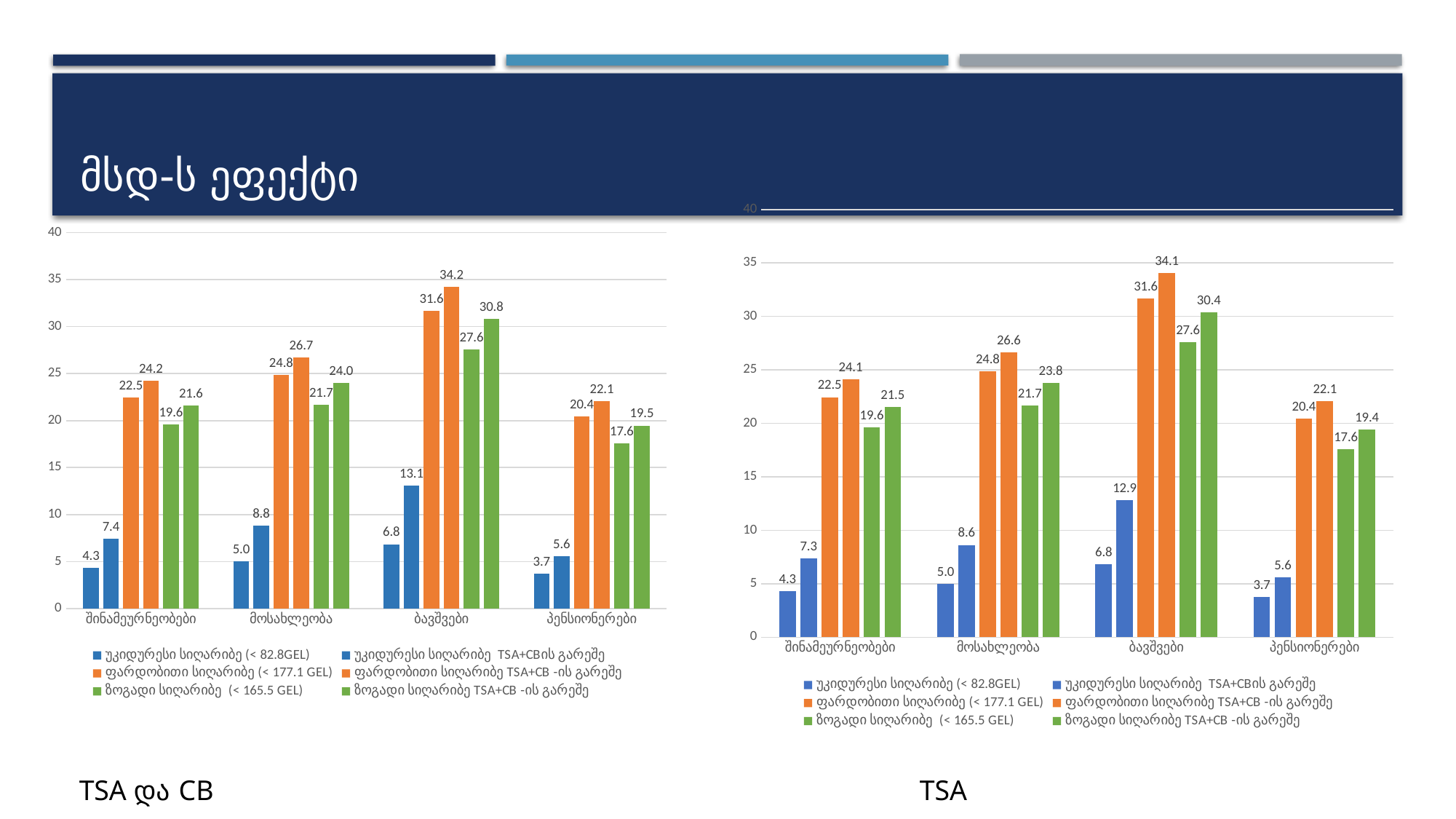
In the left chart (TSA და CB), what is the value of ფარდობითი სიღარიბე TSA+CB -ის გარეშე for მოსახლეობა? 26.7 In the right chart (TSA), what is the difference between ფარდობითი სიღარიბე TSA+CB -ის გარეშე (34.1) and ფარდობითი სიღარიბე (< 177.1 GEL) (31.6) for ბავშვები? 2.5 Which is larger: the ზოგადი სიღარიბე TSA+CB -ის გარეშე value for ბავშვები in the left chart or in the right chart? Left chart (30.8) How many categories are shown on the x axis of the right chart (TSA)? 4 In the right chart (TSA), what is the value of ზოგადი სიღარიბე TSA+CB -ის გარეშე for პენსიონერები? 19.4 In the right chart (TSA), which category has the lowest value for უკიდურესი სიღარიბე (< 82.8GEL)? პენსიონერები In the left chart (TSA და CB), which category has the highest value for ფარდობითი სიღარიბე TSA+CB -ის გარეშე? ბავშვები What type of chart is the left chart (TSA და CB)? Bar chart How many series does the legend of the left chart (TSA და CB) list? 6 In the left chart (TSA და CB), what is the value of the second bar (უკიდურესი სიღარიბე TSA+CBის გარეშე) for ბავშვები? 13.1 In the left chart (TSA და CB), what is the difference between the two უკიდურესი სიღარიბე bars for ბავშვები (13.1 and 6.8)? 6.3 In the right chart (TSA), what is the value of the second bar (უკიდურესი სიღარიბე TSA+CBის გარეშე) for ბავშვები? 12.9